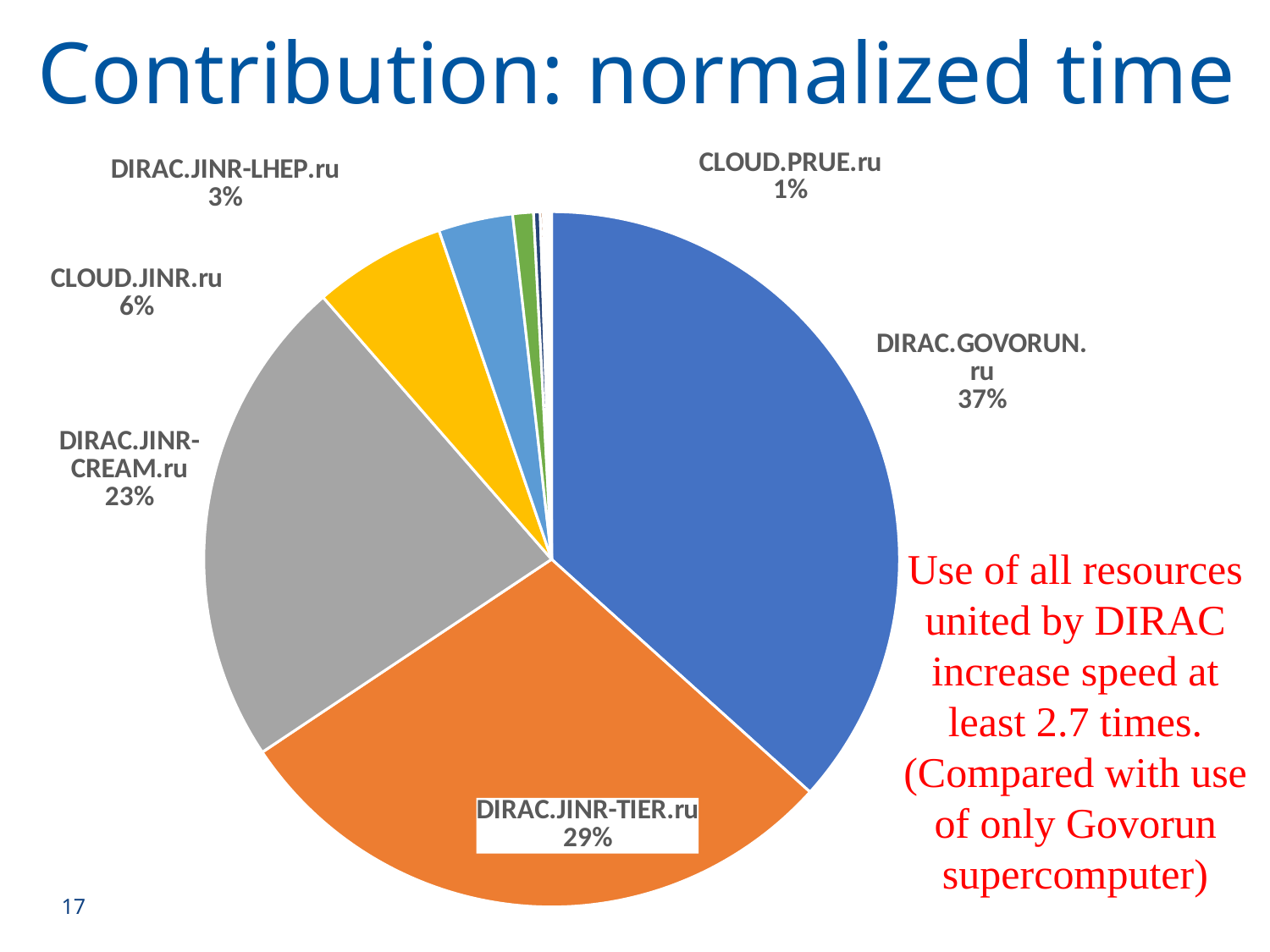
What percentage is shown for DIRAC.JINR-LHEP.ru? 3% What is the difference in percentage points between DIRAC.GOVORUN.ru and DIRAC.JINR-TIER.ru? 8 What percentage is shown for DIRAC.JINR-CREAM.ru? 23% What kind of chart is shown on the slide? pie chart What colour is the DIRAC.JINR-TIER.ru slice? orange What percentage is shown for CLOUD.PRUE.ru? 1% What share of the pie does DIRAC.GOVORUN.ru account for? 37% Which slice of the pie is the largest? DIRAC.GOVORUN.ru What percentage is shown for DIRAC.JINR-TIER.ru? 29% Which has a larger share, DIRAC.JINR-CREAM.ru or CLOUD.JINR.ru? DIRAC.JINR-CREAM.ru What is the title of the chart on the slide? Contribution: normalized time What percentage is shown for CLOUD.JINR.ru? 6%